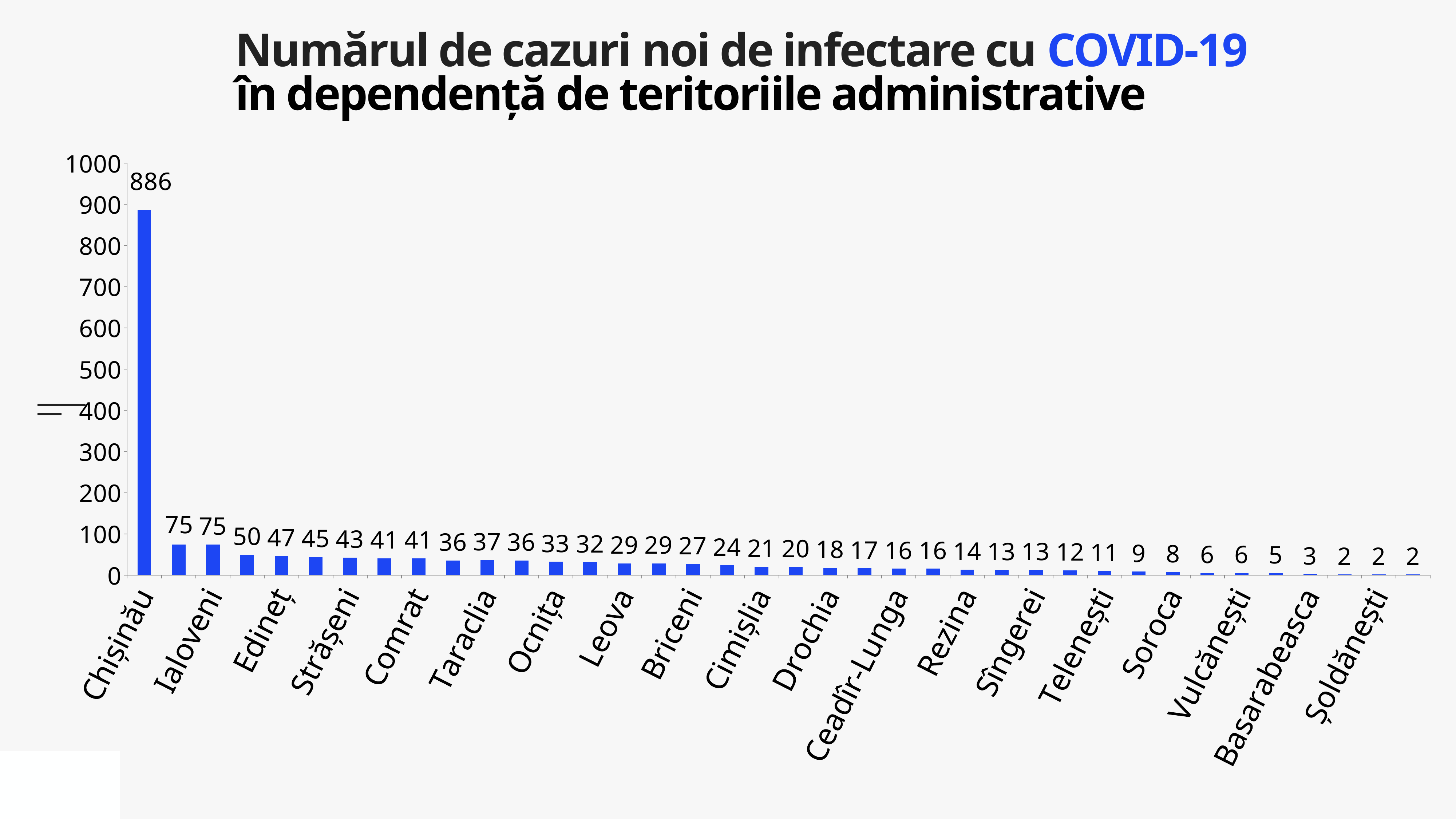
Which has more new cases, Ialoveni or Comrat? Ialoveni Is the value for Chișinău greater or less than 800? greater How many new COVID-19 cases are shown for Ialoveni? 75 How many new COVID-19 cases are shown for Comrat? 41 What type of chart is shown on the slide? bar chart Which territory has the highest number of new COVID-19 cases? Chișinău How many new COVID-19 cases are shown for Șoldănești? 2 How many new COVID-19 cases are shown for Leova? 29 What is the difference between the number of cases in Chișinău and in Ialoveni? 811 Do the values rise or fall moving from left to right along the x axis? fall What is the title of the chart? Numărul de cazuri noi de infectare cu COVID-19 în dependență de teritoriile administrative How many new COVID-19 cases are shown for Chișinău? 886